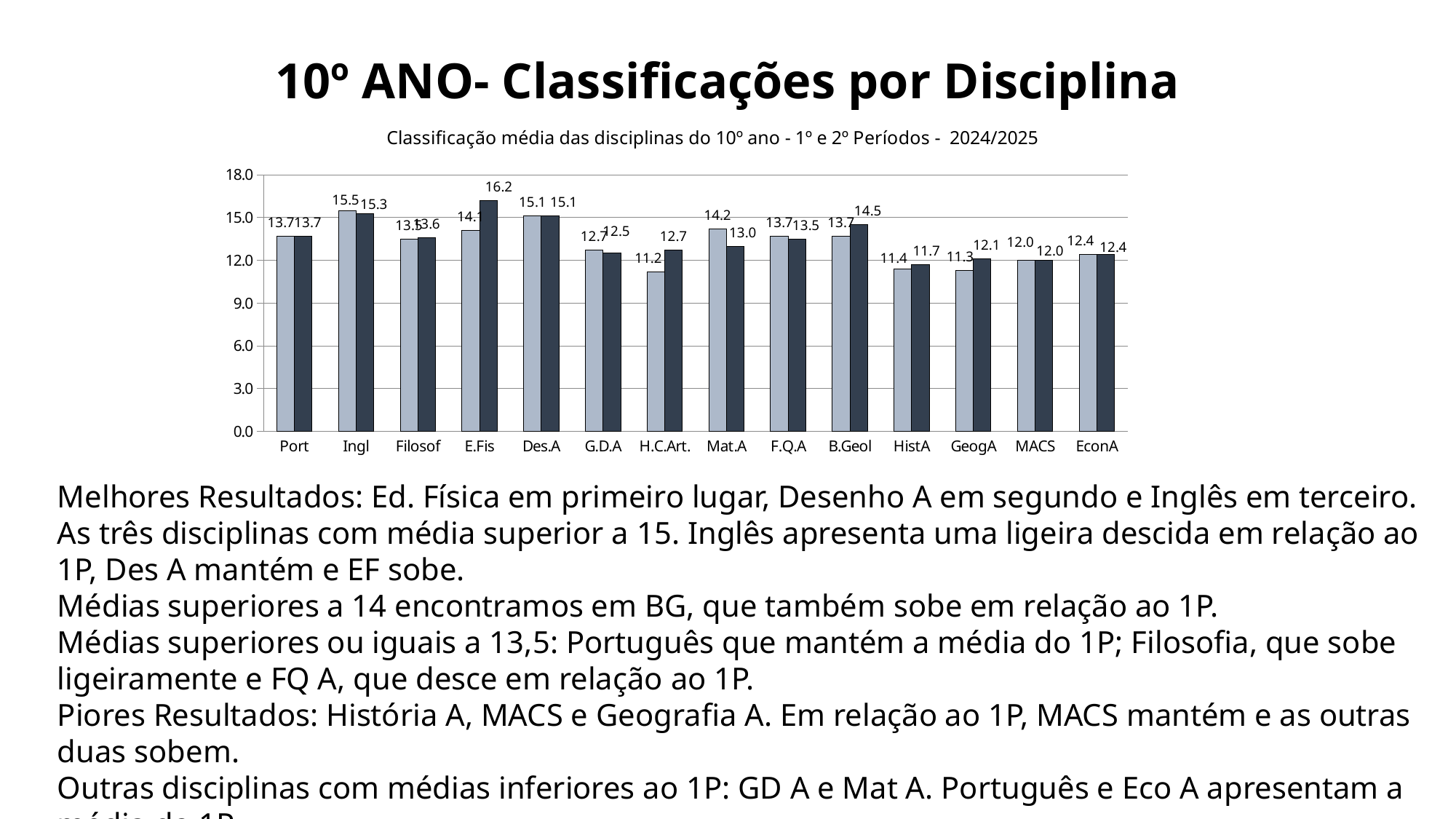
What is the difference between the lighter and darker bars for Mat.A? 1.2 How many disciplines (categories) are shown on the x axis of the chart? 14 What kind of chart is shown on the slide? bar chart What is the value of the darker (second) bar for B.Geol? 14.5 What is the value of the lighter (first) bar for H.C.Art.? 11.2 What is the value of the darker (second) bar for E.Fis? 16.2 Which discipline has the lowest lighter (first) bar? H.C.Art. Which is larger for GeogA, the lighter (first) bar or the darker (second) bar? the darker (second) bar What is the subtitle printed above the chart? Classificação média das disciplinas do 10º ano - 1º e 2º Períodos - 2024/2025 What is the value of the lighter (first) bar for Ingl? 15.5 What is the difference between the darker and lighter bars for E.Fis? 2.1 Which discipline has the highest darker (second) bar? E.Fis